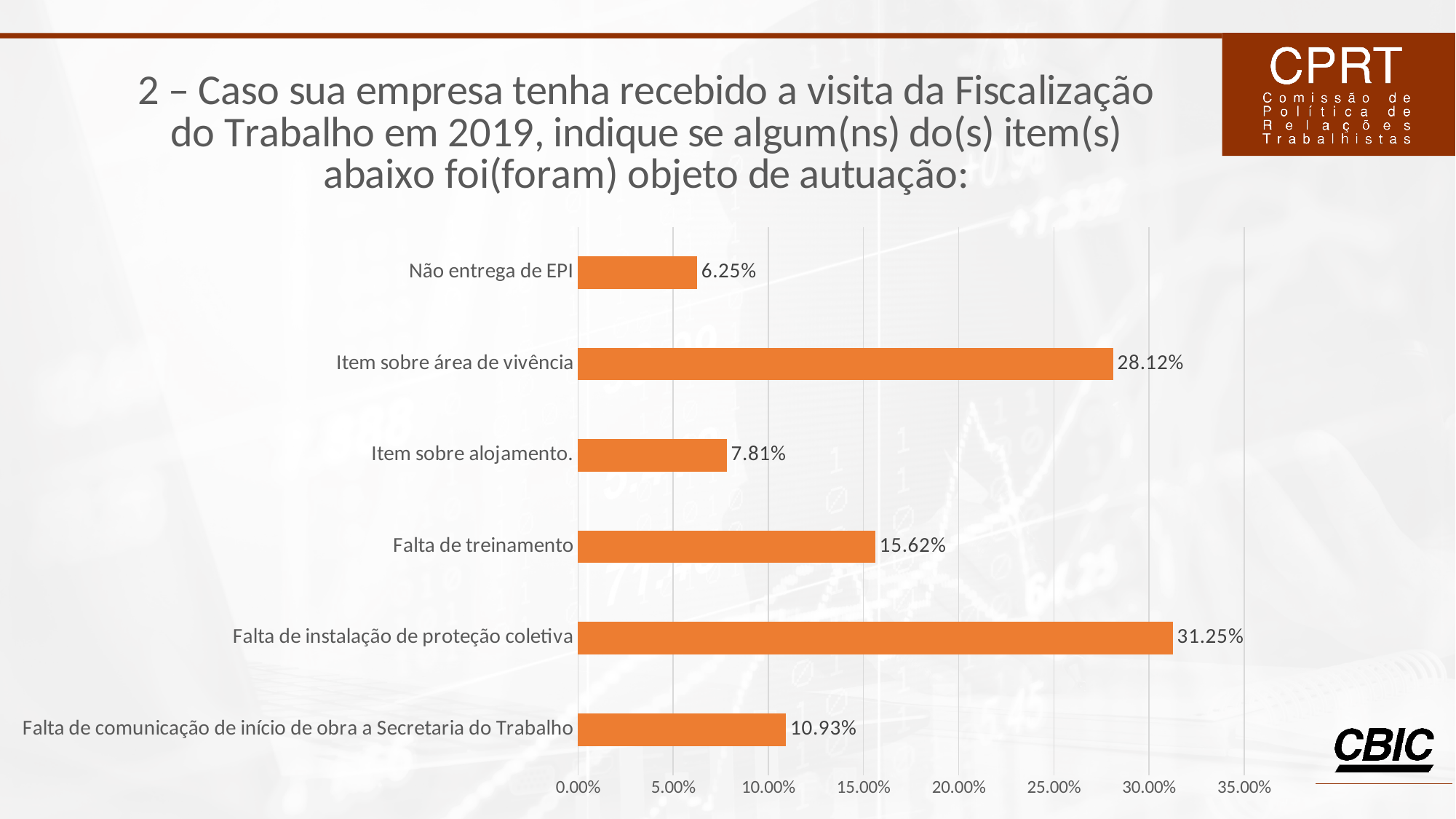
What is the difference between "Falta de instalação de proteção coletiva" and "Item sobre área de vivência"? 3.13% What is the value for "Falta de treinamento"? 15.62% Is the value for "Falta de instalação de proteção coletiva" greater or less than 30.00%? greater Which is larger, "Item sobre alojamento." or "Falta de treinamento"? Falta de treinamento What is the highest value shown on the x axis? 35.00% How many categories are shown in the chart? 6 What kind of chart is shown on the slide? bar chart What is the value for "Falta de comunicação de início de obra a Secretaria do Trabalho"? 10.93% Which category has the lowest value? Não entrega de EPI What is the value for "Item sobre área de vivência"? 28.12% What is the value for "Não entrega de EPI"? 6.25% Which category has the highest value? Falta de instalação de proteção coletiva